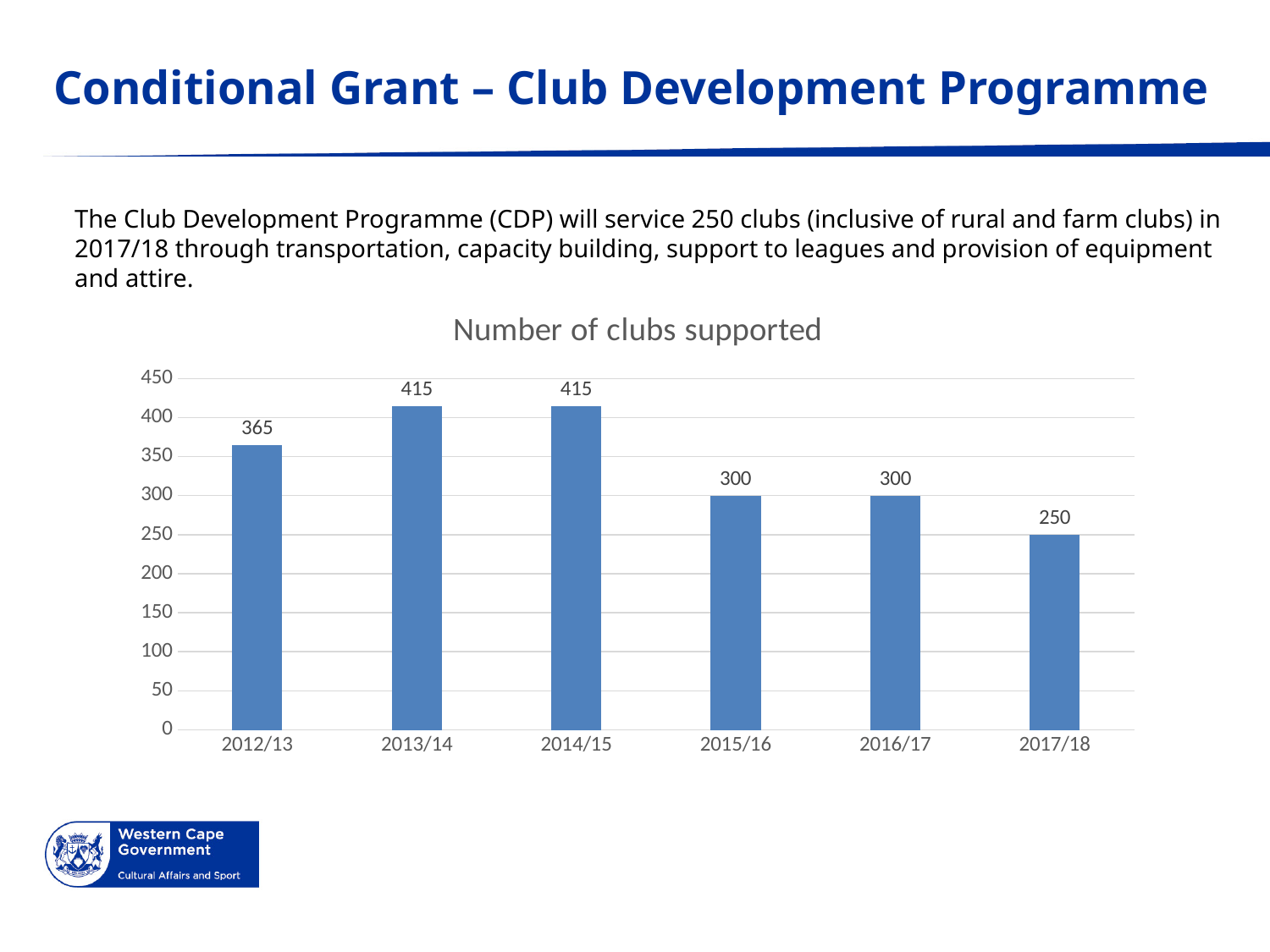
How many years are shown on the x axis of the chart? 6 Which year has the lowest number of clubs supported? 2017/18 Do the values rise or fall from 2014/15 to 2017/18? Fall What is the number of clubs supported in 2015/16? 300 Which is larger, the number of clubs supported in 2012/13 or in 2016/17? 2012/13 What kind of chart is shown on the slide? Bar chart What is the difference between the number of clubs supported in 2013/14 and 2017/18? 165 What is the number of clubs supported in 2017/18? 250 What is the number of clubs supported in 2012/13? 365 Is the value for 2012/13 greater or less than 350? greater What is the title of the chart? Number of clubs supported What is the difference between the number of clubs supported in 2012/13 and 2015/16? 65